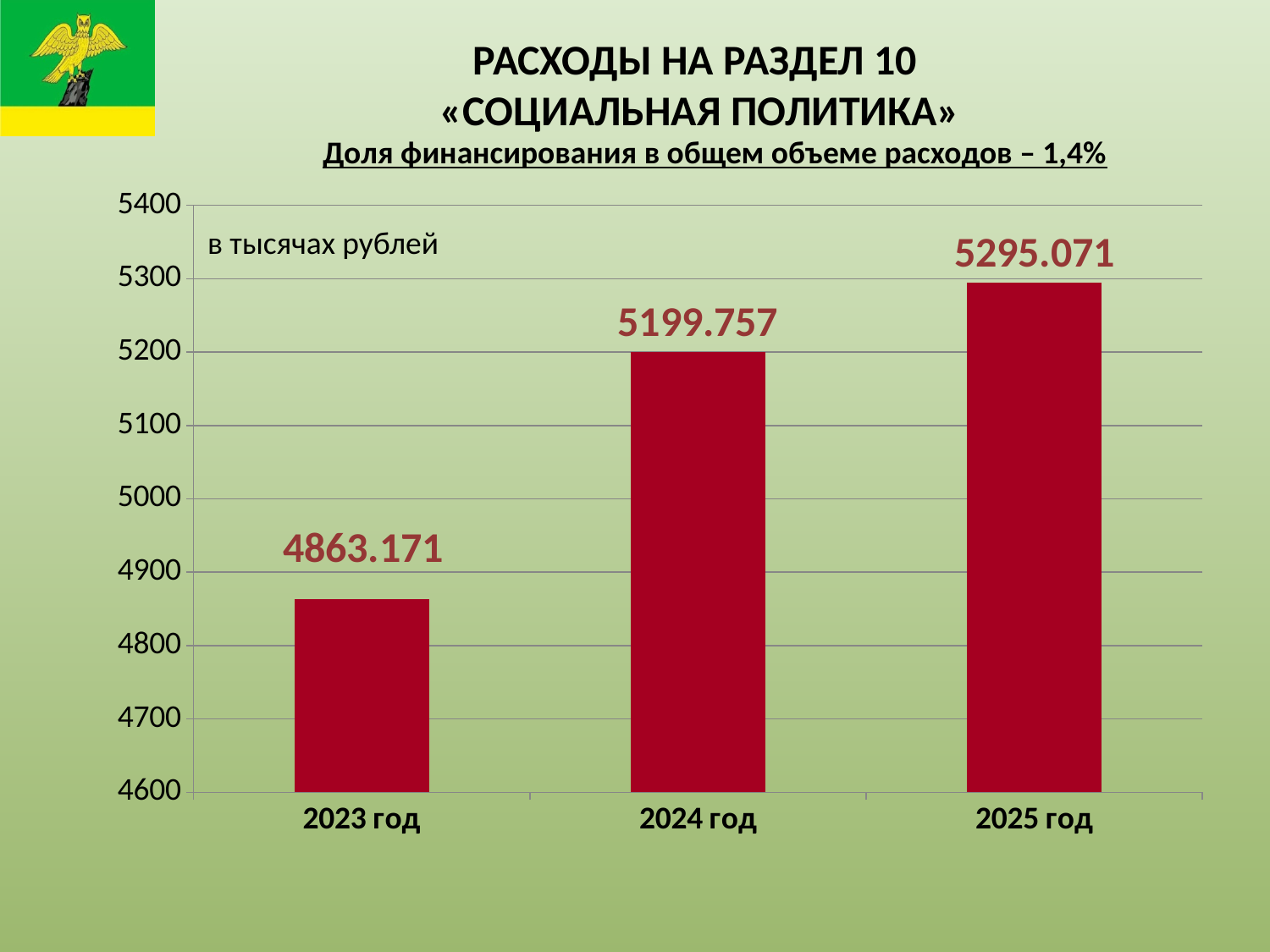
Which year has the highest value? 2025 год Do the values rise or fall from 2023 год to 2025 год? rise Is the value for 2023 год greater or less than 4900? less What is the difference between the values for 2025 год and 2024 год? 95.314 How many years are shown on the chart? 3 Which is larger, the value for 2023 год or the value for 2024 год? 2024 год What is the value shown for 2024 год? 5199.757 What is the difference between the values for 2024 год and 2023 год? 336.586 What is the value shown for 2025 год? 5295.071 What is the value shown for 2023 год? 4863.171 What kind of chart is shown on the slide? bar chart Which year has the lowest value? 2023 год